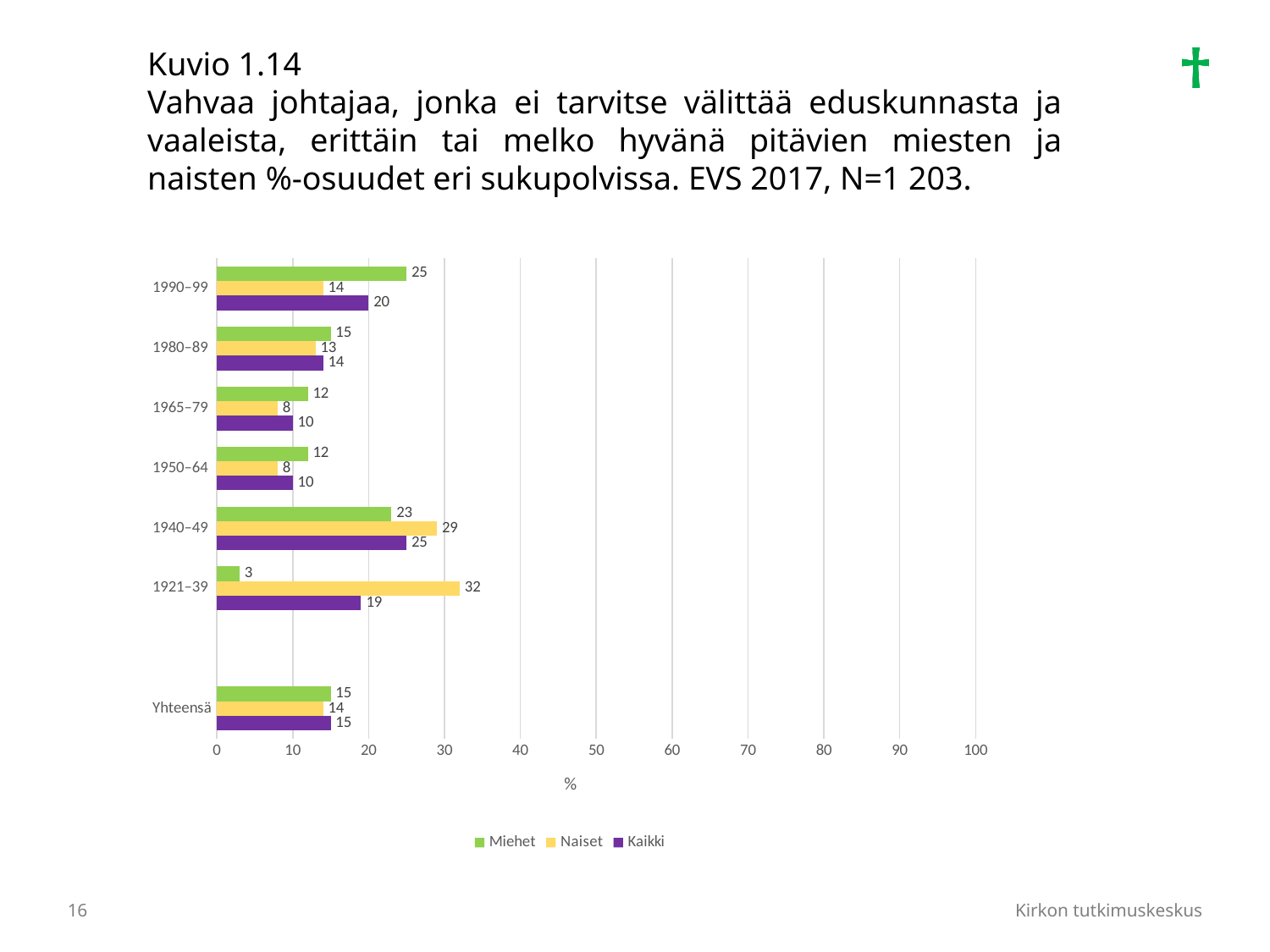
What is the value for Kaikki in the Yhteensä category? 15 Which generation has the lowest value for Miehet? 1921–39 Which is larger in the 1940–49 generation, the Miehet value or the Naiset value? Naiset What is the value for Naiset in the 1921–39 generation? 32 How many categories are shown on the vertical axis of the chart? 7 What kind of chart is shown on the slide? bar chart Which generation has the highest value for Naiset? 1921–39 Is the value for Naiset in the 1940–49 generation greater or less than 20? greater How many series does the legend list? 3 What is the value for Miehet in the 1990–99 generation? 25 What is the difference between the Naiset and Miehet values in the 1921–39 generation? 29 What label is shown on the horizontal axis of the chart? %